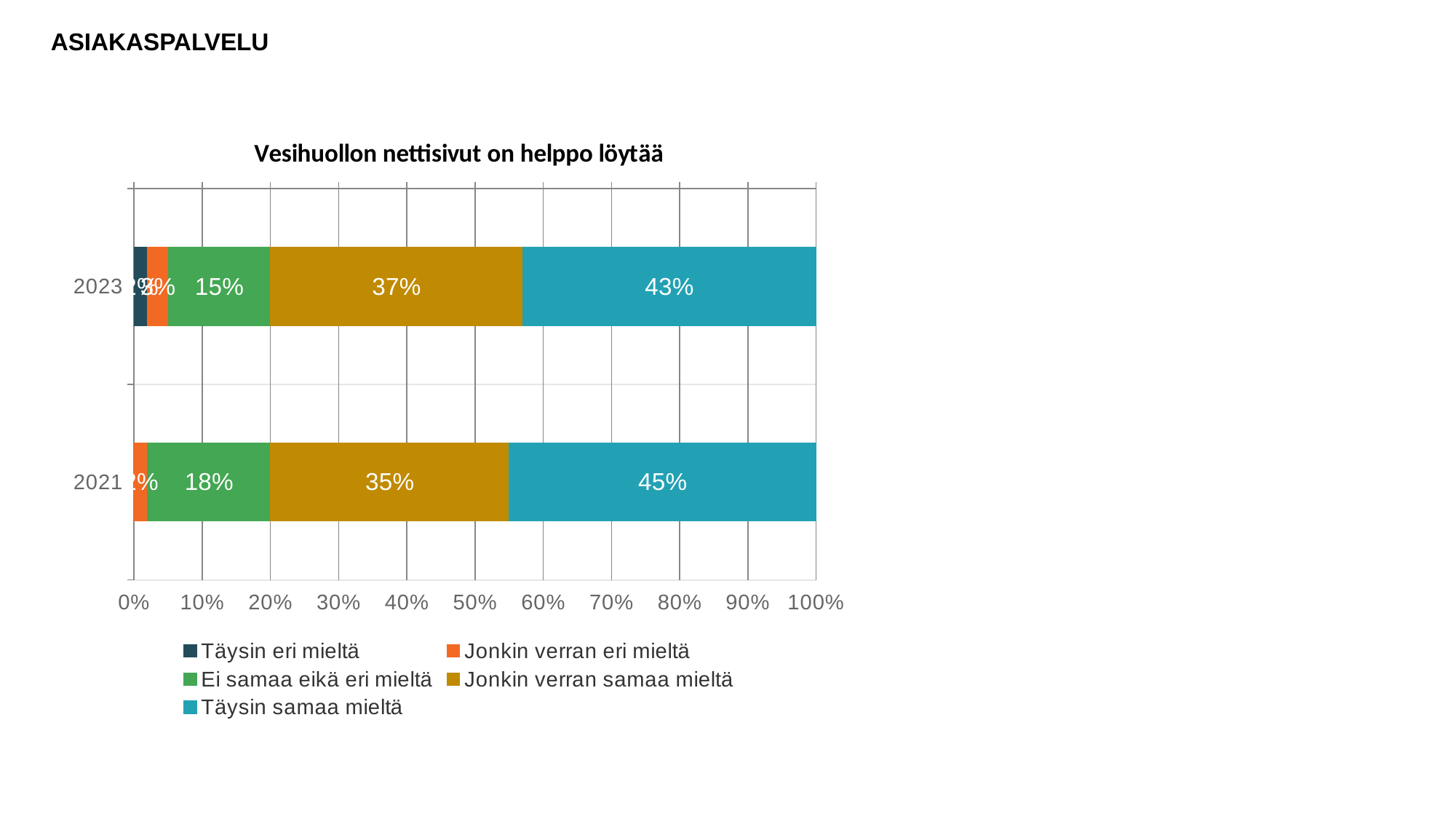
What kind of chart is shown on the slide? Stacked bar chart Which year has the larger value for "Jonkin verran samaa mieltä", 2021 or 2023? 2023 What is the value for "Täysin samaa mieltä" in 2023? 43% What is the value for "Jonkin verran samaa mieltä" in 2021? 35% How many years (categories) are shown in the chart? 2 Which response category has the largest share in the 2023 bar? Täysin samaa mieltä What is the title of the chart? Vesihuollon nettisivut on helppo löytää What is the difference between the "Ei samaa eikä eri mieltä" values for 2021 and 2023? 3 percentage points How many series does the legend list? 5 What is the difference between the "Täysin samaa mieltä" values for 2021 and 2023? 2 percentage points What is the value for "Täysin samaa mieltä" in 2021? 45% What is the value for "Ei samaa eikä eri mieltä" in 2023? 15%